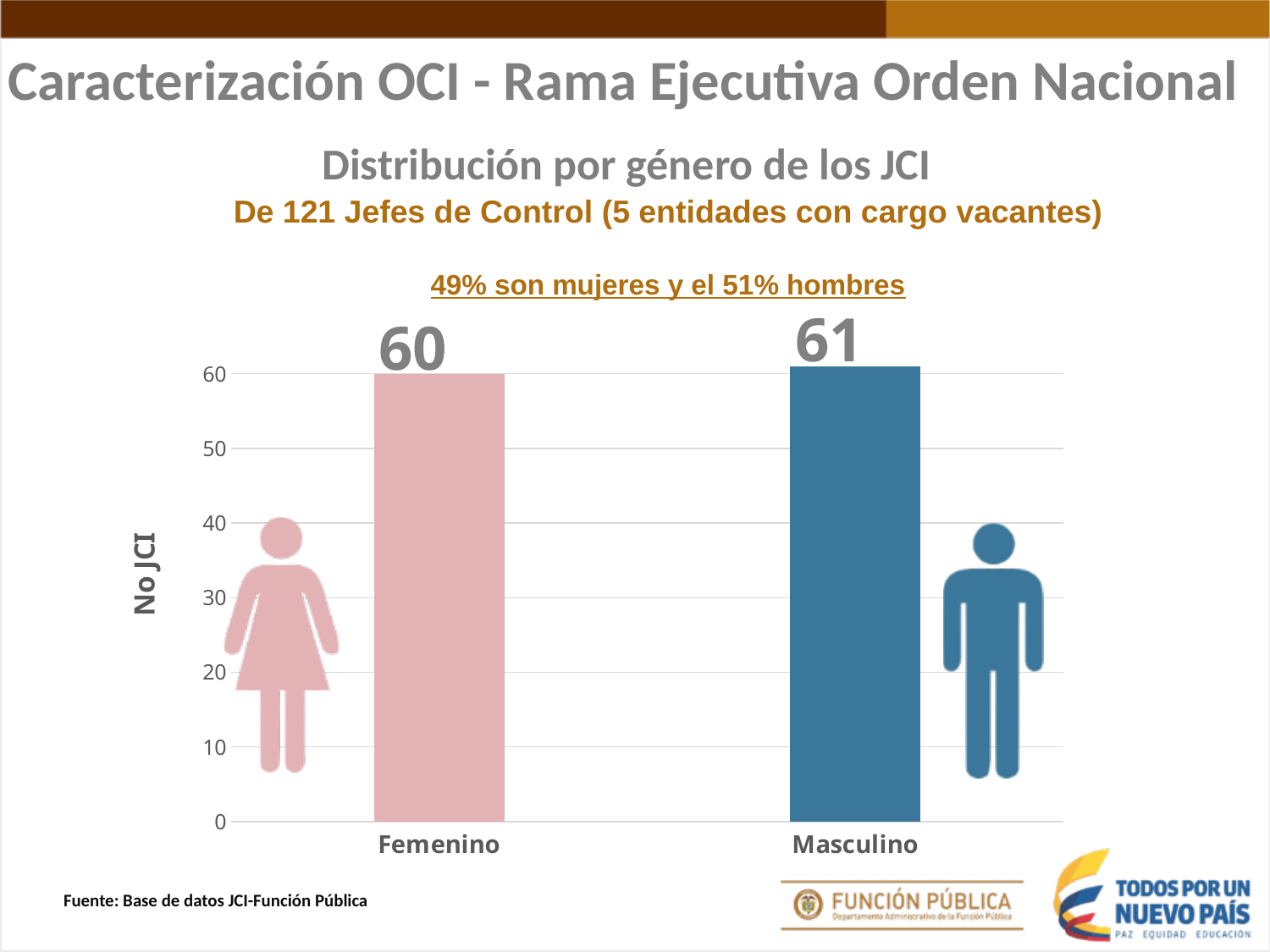
How many categories are shown on the x axis? 2 Is the value for Femenino greater or less than 50? greater What is the label of the y axis? No JCI What is the value for Femenino? 60 Which category has the highest value? Masculino Which category has the lowest value? Femenino What colour is the bar for Masculino? blue What is the difference between the values for Masculino and Femenino? 1 What is the value for Masculino? 61 What kind of chart is shown on the slide? bar chart What is the total of the values for Femenino and Masculino? 121